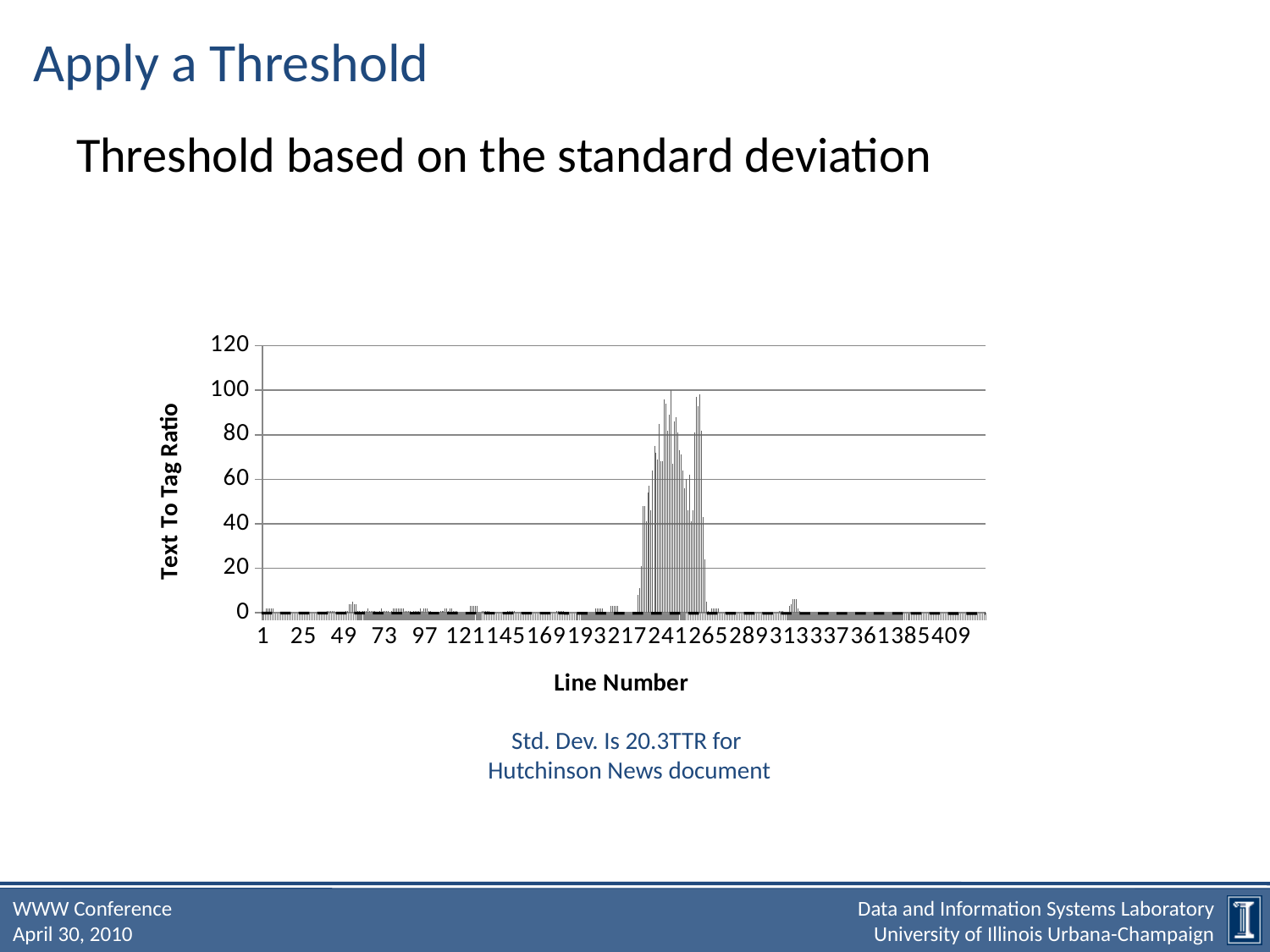
What kind of chart is shown on the slide? Bar chart Is the value for line number 1 greater or less than 20? less What is the title of the x axis of the chart? Line Number How many tick labels are printed along the x axis of the chart? 18 Is the value for line number 121 greater or less than 40? less Is the tallest bar in the chart greater or less than 80? greater What is the title of the y axis of the chart? Text To Tag Ratio Which is larger, the value at line number 241 or the value at line number 25? Line number 241 Around which x-axis tick label do the tallest bars of the chart appear? 241